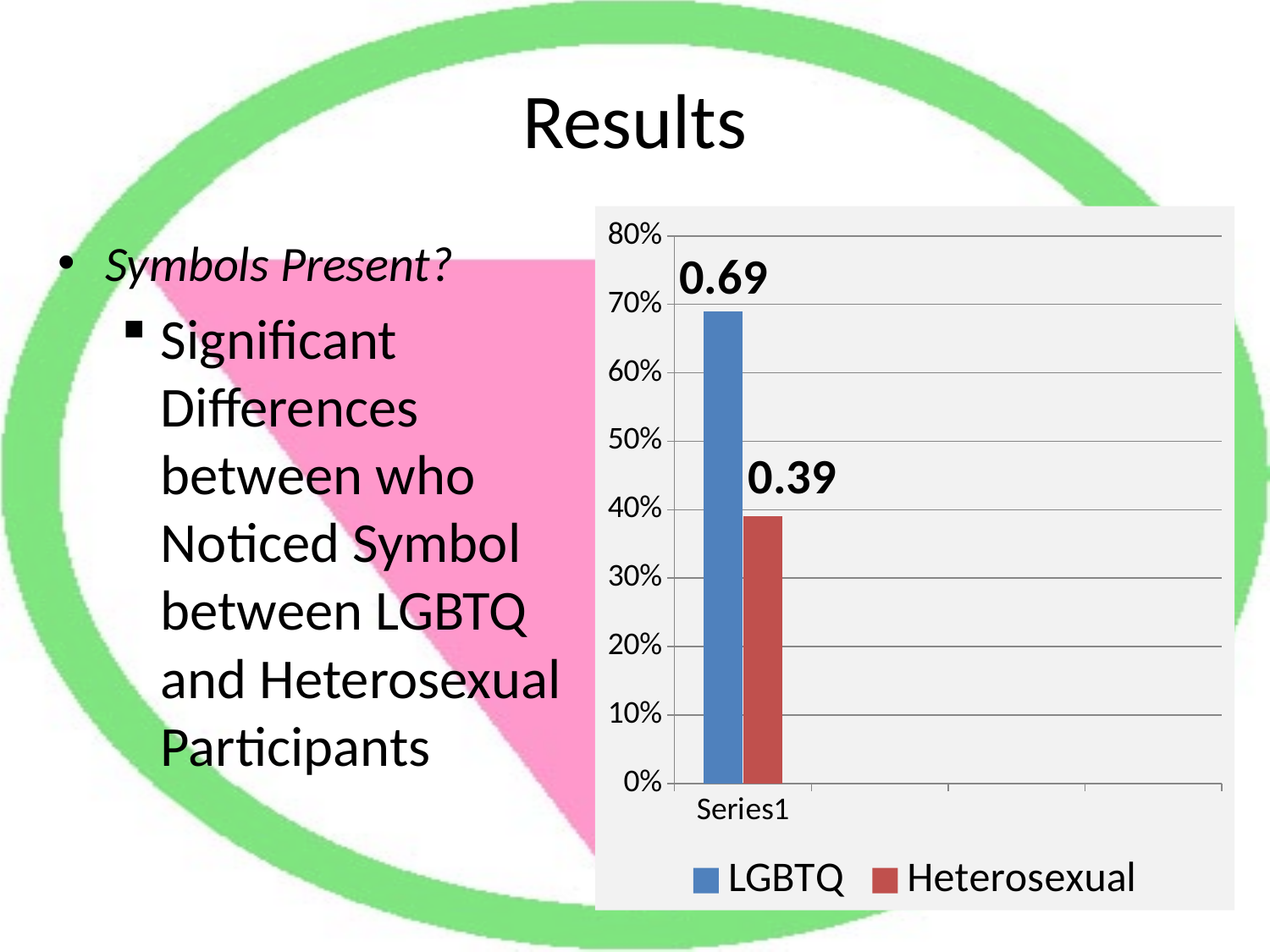
What is the difference between the LGBTQ and Heterosexual values? 0.30 Is the value for LGBTQ greater or less than 60%? greater What is the category label on the x axis? Series1 How many series does the legend list? 2 Is the value for Heterosexual greater or less than 40%? less What colour is the bar for Heterosexual? red Which series has the lowest value? Heterosexual What kind of chart is shown? bar chart What is the value for LGBTQ? 0.69 What is the value for Heterosexual? 0.39 What is the highest value shown on the y axis? 80% Which series has the higher value, LGBTQ or Heterosexual? LGBTQ